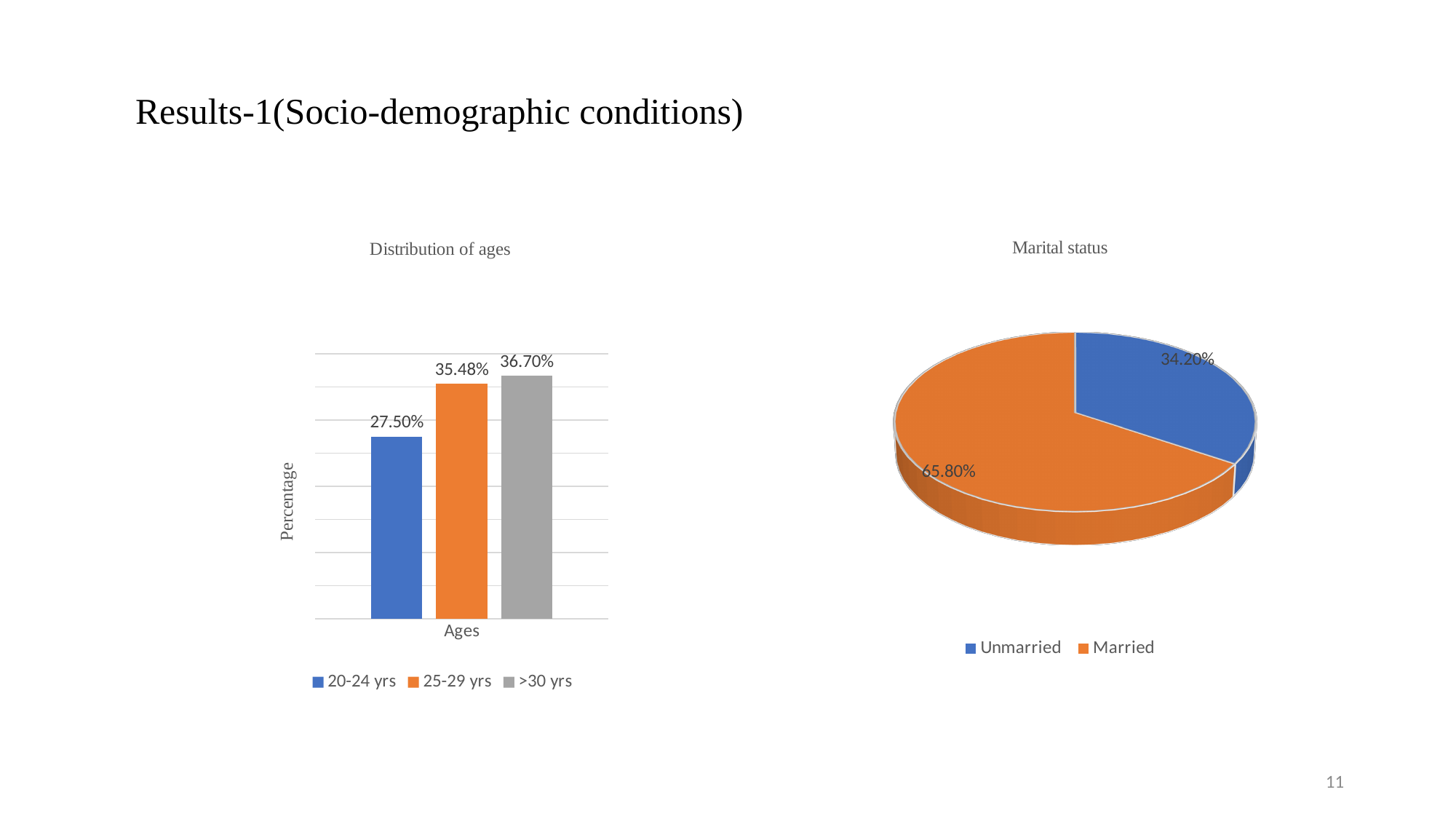
In the 'Distribution of ages' chart, which age group has the highest value? >30 yrs In the 'Distribution of ages' chart, what is the value for 20-24 yrs? 27.50% In the 'Distribution of ages' chart, what is the value for 25-29 yrs? 35.48% What kind of chart is the 'Marital status' chart? Pie chart In the 'Marital status' chart, what share of the pie is Married? 65.80% In the 'Distribution of ages' chart, what is the value for >30 yrs? 36.70% What kind of chart is the 'Distribution of ages' chart? Bar chart In the 'Distribution of ages' chart, how many series does the legend list? 3 In the 'Distribution of ages' chart, which age group has the lowest value? 20-24 yrs In the 'Marital status' chart, which is larger, Married or Unmarried? Married In the 'Distribution of ages' chart, what is the difference between the values for >30 yrs and 20-24 yrs? 9.20% In the 'Marital status' chart, what share of the pie is Unmarried? 34.20%